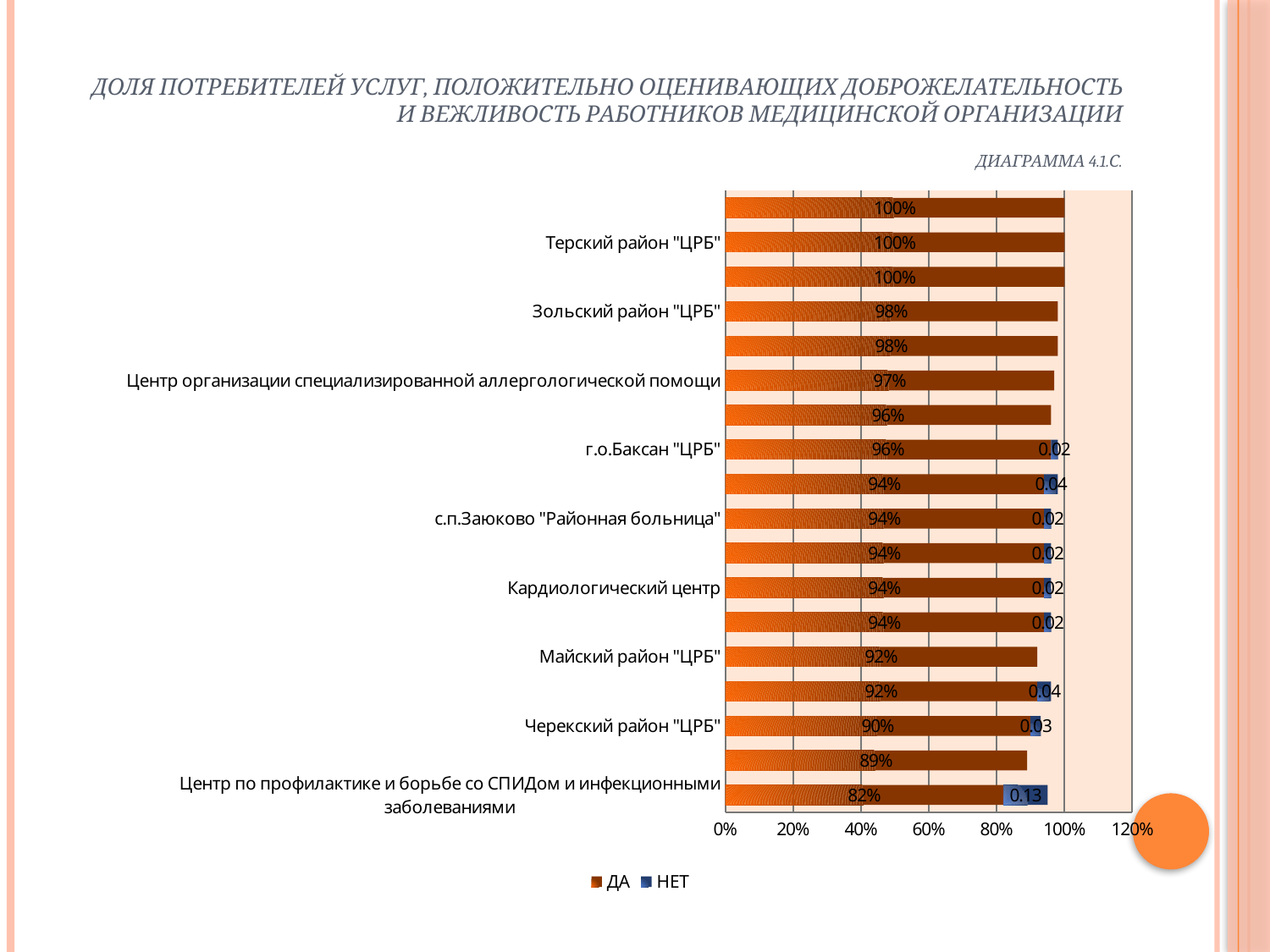
Which labelled organisation has the lowest ДА value? Центр по профилактике и борьбе со СПИДом и инфекционными заболеваниями What is the ДА value for Зольский район "ЦРБ"? 98% What is the difference between the ДА values for Терский район "ЦРБ" and Черекский район "ЦРБ"? 10% What is the НЕТ value for г.о.Баксан "ЦРБ"? 0.02 What is the НЕТ value for Черекский район "ЦРБ"? 0.03 What is the ДА value for Центр организации специализированной аллергологической помощи? 97% What is the ДА value for Центр по профилактике и борьбе со СПИДом и инфекционными заболеваниями? 82% Which has a larger ДА value, Зольский район "ЦРБ" or Майский район "ЦРБ"? Зольский район "ЦРБ" What kind of chart is shown on the slide? Bar chart How many series does the legend list? 2 What are the two entries in the chart legend? ДА and НЕТ What is the ДА value for Терский район "ЦРБ"? 100%